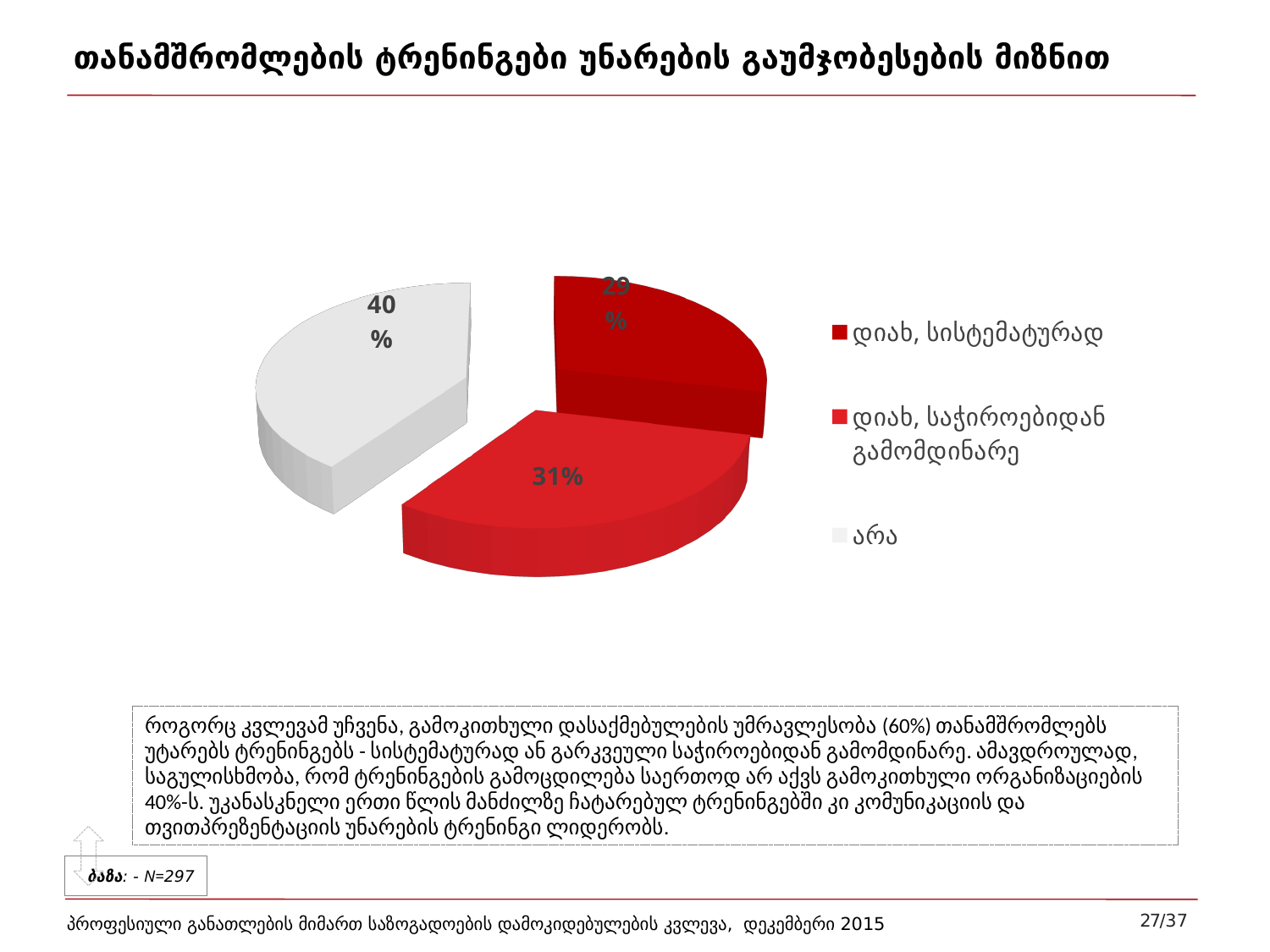
Which slice has the largest share of the pie? არა What is the difference between the "დიახ, საჭიროებიდან გამომდინარე" slice and the "დიახ, სისტემატურად" slice? 2% How many slices does the pie chart have? 3 What is the value for the slice "დიახ, სისტემატურად"? 29% What is the value for the slice "არა"? 40% What is the combined share of the two "დიახ" slices? 60% What kind of chart is shown on the slide? pie chart Which is larger: the "არა" slice or the "დიახ, საჭიროებიდან გამომდინარე" slice? არა Which slice has the smallest share of the pie? დიახ, სისტემატურად What is the value for the slice "დიახ, საჭიროებიდან გამომდინარე"? 31% What colour is the "არა" slice in the pie chart? light gray What is the difference between the "არა" slice and the "დიახ, სისტემატურად" slice? 11%